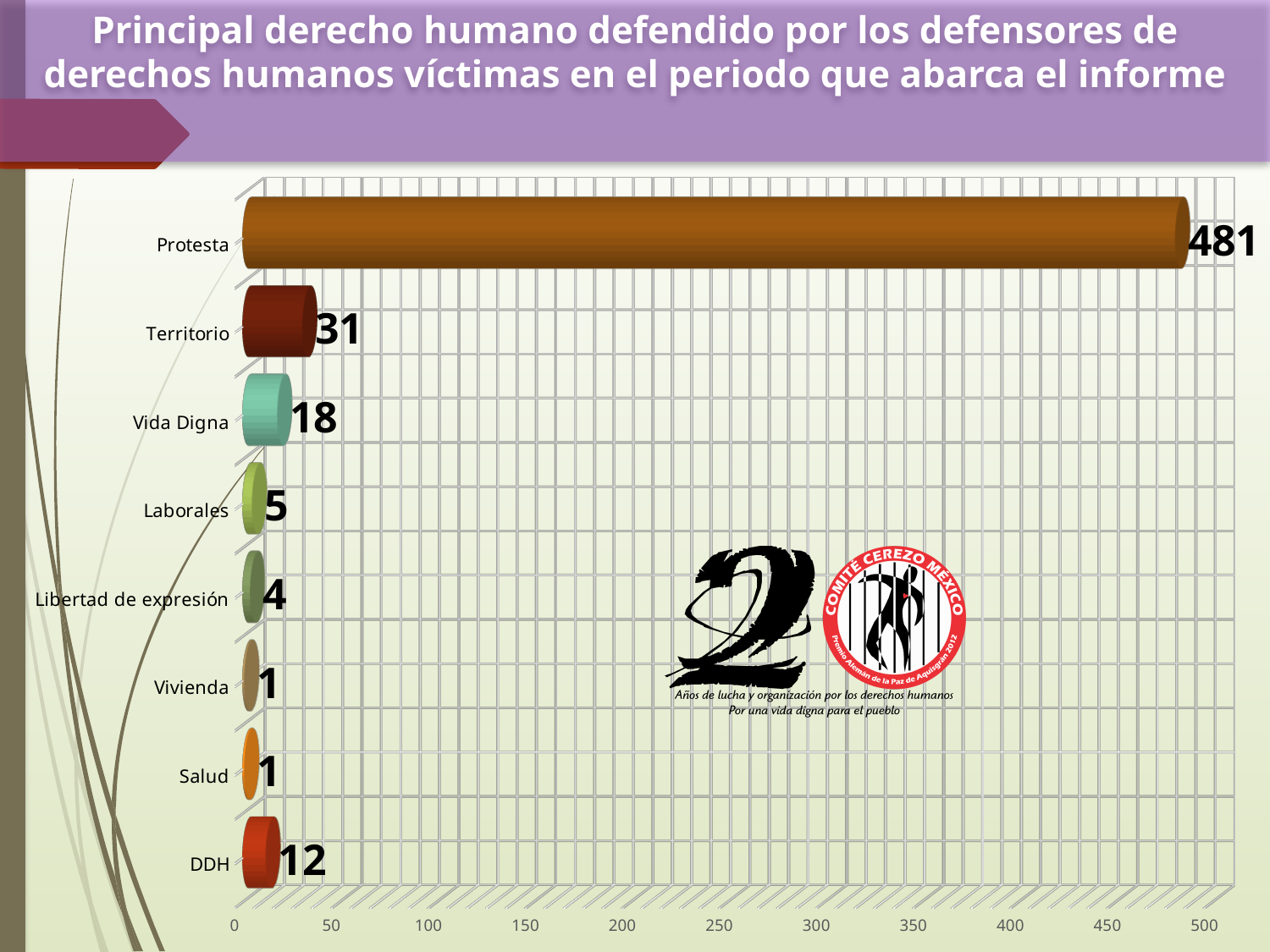
Which category has the highest value? Protesta Is the value for Protesta greater or less than 450? greater What is the value for Libertad de expresión? 4 What is the value for DDH? 12 What is the value for Territorio? 31 What is the value for Vida Digna? 18 What is the difference between the values for Vida Digna and Laborales? 13 What kind of chart is shown on the slide? bar chart What is the difference between the values for Protesta and Territorio? 450 Which is larger, the value for DDH or the value for Laborales? DDH How many categories are shown in the chart? 8 What is the value for Protesta? 481